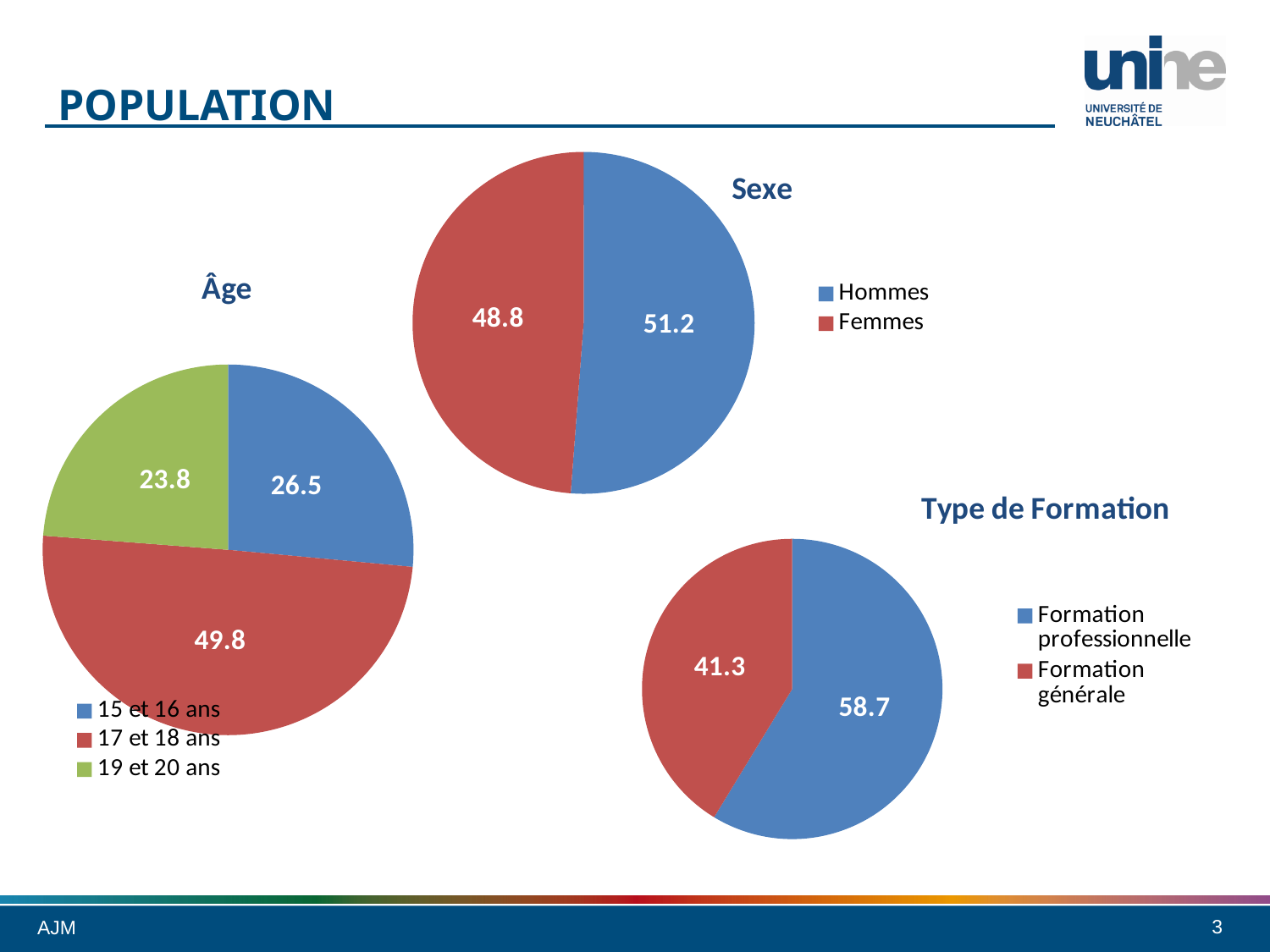
In the "Âge" chart, what is the difference between the values for "17 et 18 ans" and "15 et 16 ans"? 23.3 What kind of chart is the "Sexe" chart? Pie chart In the "Type de Formation" chart, what is the difference between the values for "Formation professionnelle" and "Formation générale"? 17.4 How many categories does the "Âge" chart show? 3 In the "Sexe" chart, what is the value for "Hommes"? 51.2 In the "Type de Formation" chart, what is the value for "Formation professionnelle"? 58.7 In the "Âge" chart, which category has the largest slice? 17 et 18 ans In the "Âge" chart, what is the value for "17 et 18 ans"? 49.8 In the "Âge" chart, which category has the smallest slice? 19 et 20 ans In the "Âge" chart, what is the value for "19 et 20 ans"? 23.8 In the "Sexe" chart, what is the value for "Femmes"? 48.8 In the "Type de Formation" chart, which category is larger, "Formation professionnelle" or "Formation générale"? Formation professionnelle